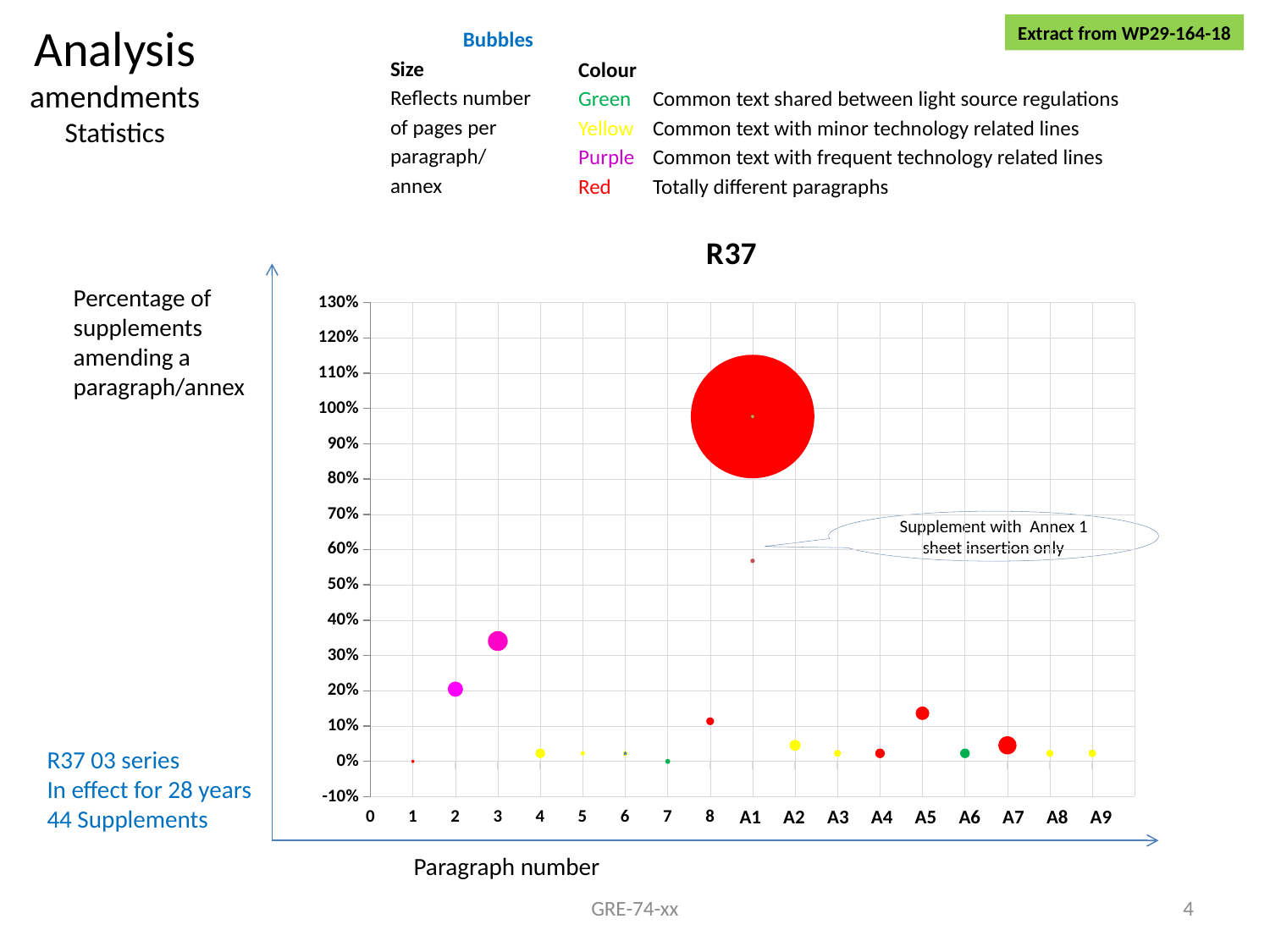
Is the value for A5 greater or less than 10%? greater Is the value for paragraph 3 greater or less than 30%? greater Is the value for paragraph 8 greater or less than 20%? less What is the title of the chart? R37 What kind of chart is shown on the slide? bubble chart Which has the larger value, paragraph 2 or paragraph 3? paragraph 3 What is the label of the x axis? Paragraph number Which paragraph number has the highest percentage of supplements amending it? A1 How many annex categories (A1 to A9) are labelled on the x axis? 9 Which has the larger value, paragraph 3 or A1? A1